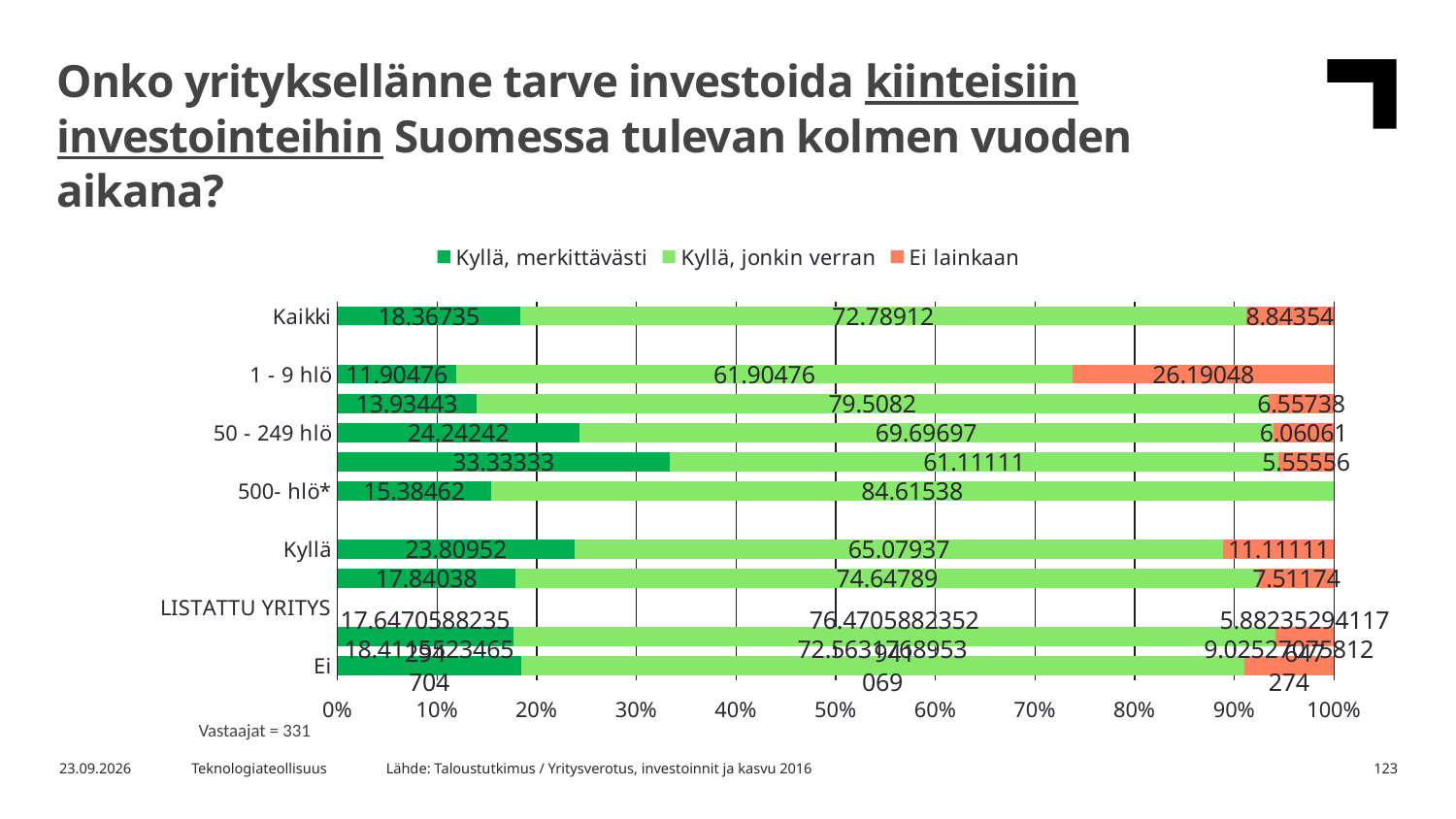
What is the value of "Ei lainkaan" for 1 - 9 hlö? 26.19048 What is the value of "Kyllä, merkittävästi" for 50 - 249 hlö? 24.24242 What is the value of "Kyllä, jonkin verran" for Kaikki? 72.78912 What kind of chart is shown on the slide? Stacked bar chart What is the value of "Kyllä, jonkin verran" for 500- hlö*? 84.61538 Which category has the highest "Ei lainkaan" value? 1 - 9 hlö What is the first entry in the chart legend? Kyllä, merkittävästi How many series does the legend list? 3 Which has a larger "Ei lainkaan" value, Kaikki or 1 - 9 hlö? 1 - 9 hlö What is the value of "Ei lainkaan" for Kyllä? 11.11111 How many respondents (Vastaajat) does the chart note state? 331 What is the difference between the "Kyllä, merkittävästi" values for Kaikki and 1 - 9 hlö? 6.46259